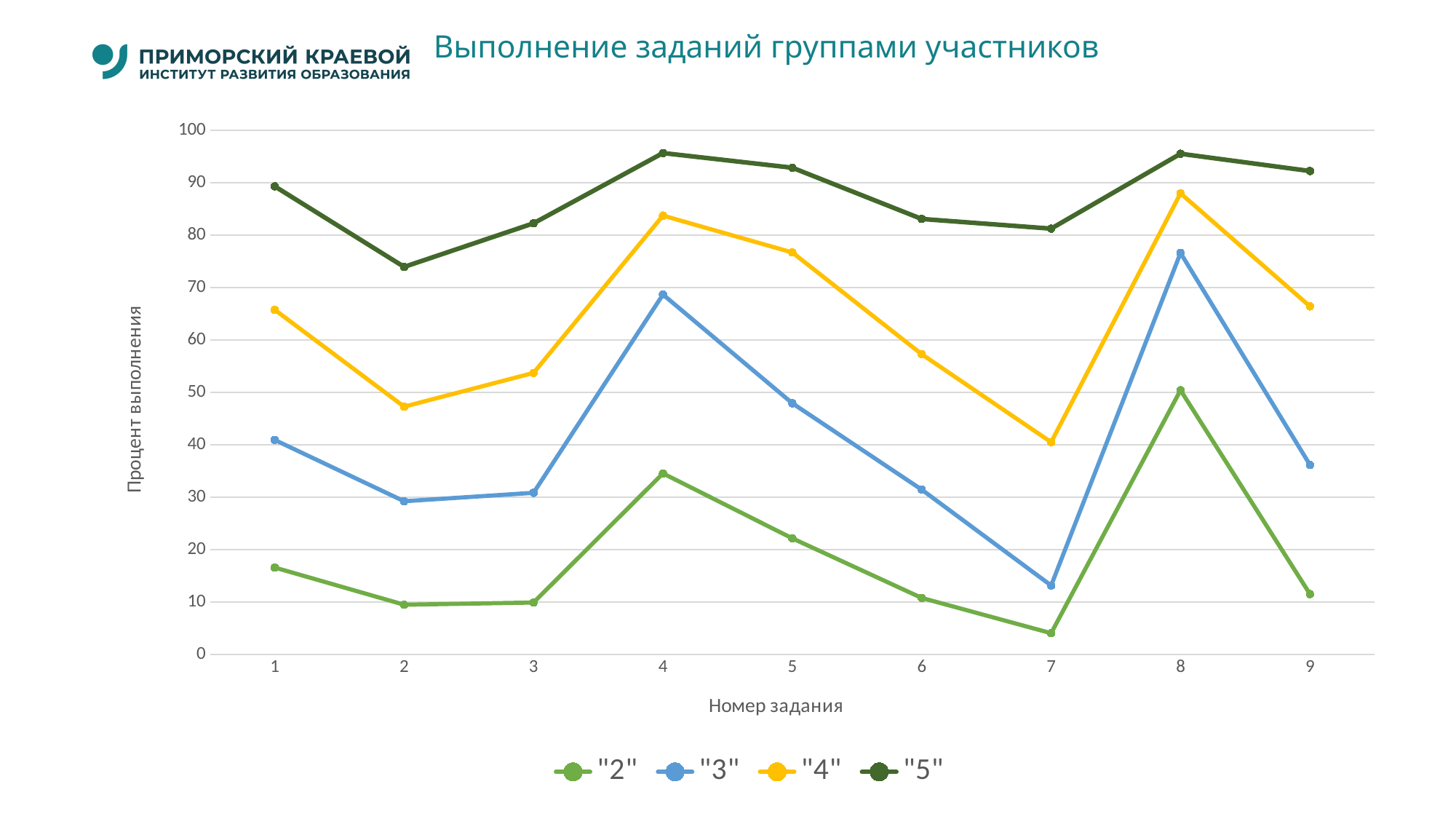
Is the value for the "3" series at task 4 greater or less than 60? greater Is the value for the "5" series at task 2 greater or less than 80? less How many task numbers are plotted along the x axis? 9 How many series does the legend list? 4 Which is larger for the "3" series: the value at task 1 or the value at task 5? task 5 For which task number does the "2" series have its lowest value? 7 Do the values of the "2" series rise or fall from task 4 to task 7? fall What kind of chart is shown on the slide? line chart For which task number does the "5" series have its lowest value? 2 For which task number does the "3" series reach its highest value? 8 For which task number does the "4" series reach its highest value? 8 Is the value for the "4" series at task 7 greater or less than 50? less